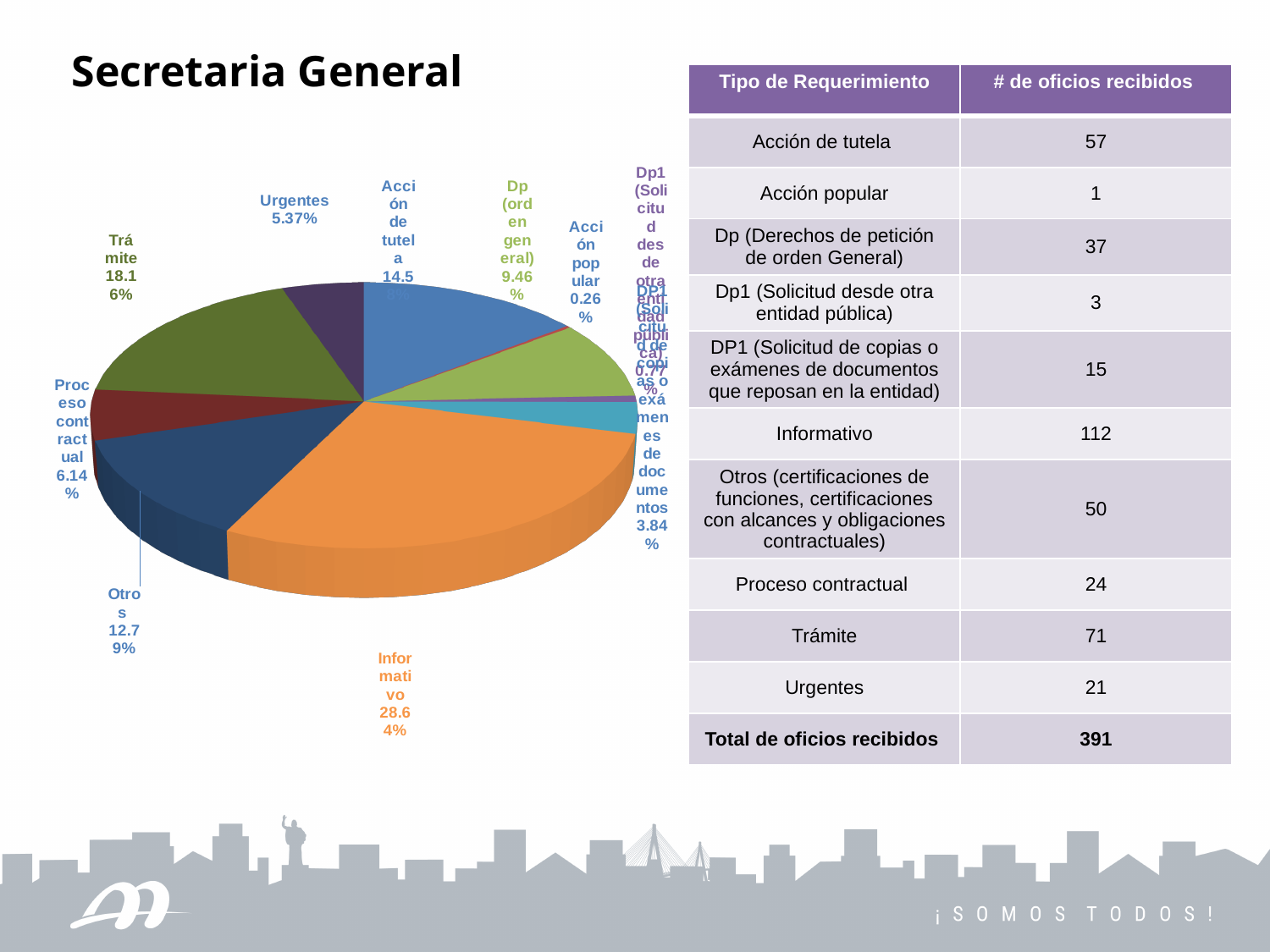
What percentage is shown for Acción popular in the pie chart? 0.26% What kind of chart is shown on the slide? pie chart What share of the pie does Informativo represent? 28.64% What percentage is shown for Urgentes in the pie chart? 5.37% What percentage is shown for Dp (orden general) in the pie chart? 9.46% What percentage is shown for Trámite in the pie chart? 18.16% Which slice is larger in the pie chart, Trámite or Otros? Trámite What percentage is shown for Proceso contractual in the pie chart? 6.14% What percentage is shown for Otros in the pie chart? 12.79% Which category has the largest slice of the pie chart? Informativo By how many percentage points does the Informativo slice exceed the Trámite slice? 10.48 Which category has the smallest slice of the pie chart? Acción popular